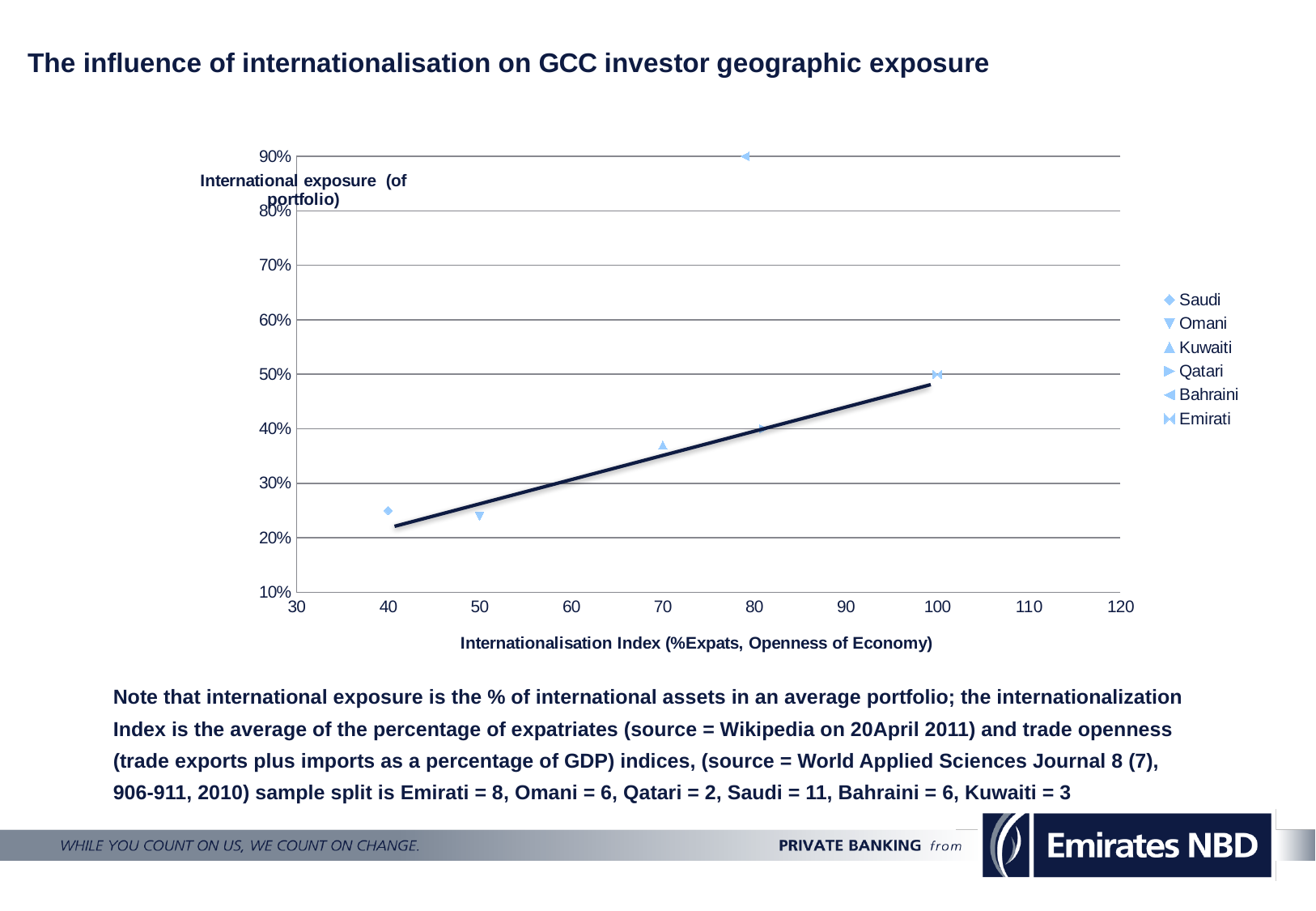
What kind of chart is shown on the slide? scatter chart What is the Internationalisation Index value for the Emirati point? 100 What is the international exposure value for the Emirati point? 50% Which has a higher international exposure, Emirati or Kuwaiti? Emirati Which series is listed first in the legend? Saudi Which series has the highest international exposure? Bahraini Is the international exposure for Kuwaiti greater or less than 30%? greater Is the international exposure for Saudi greater or less than 30%? less What is the international exposure value for the Bahraini point? 90% Does the trend line rise or fall as the Internationalisation Index increases? rises What is the title of the x axis? Internationalisation Index (%Expats, Openness of Economy) How many series does the legend list? 6